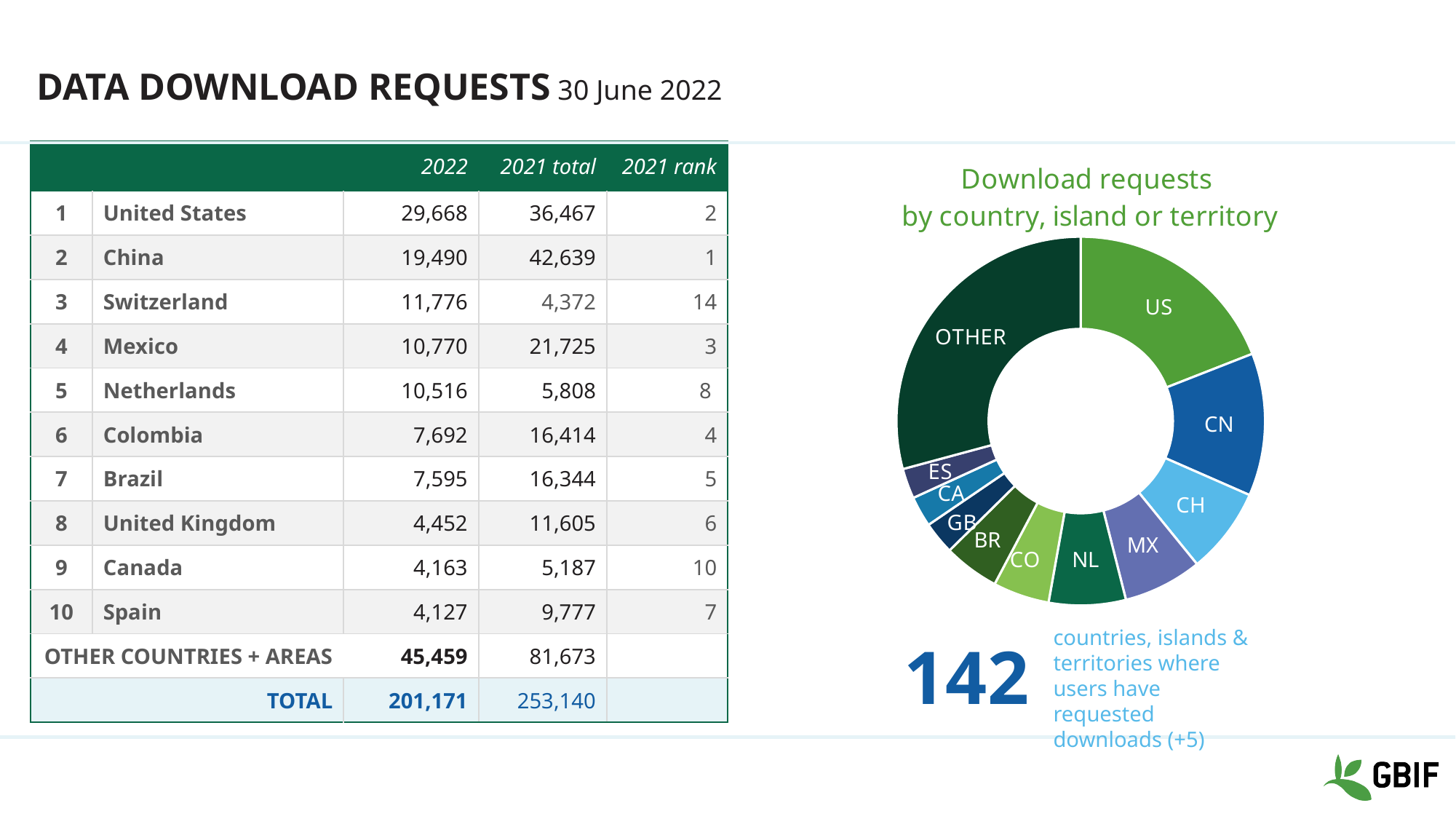
In the donut chart, which slice is larger, NL or CO? NL What is the total number of download requests in 2022 shown in the table? 201,171 In the donut chart, which slice is larger, US or CN? US Excluding the OTHER slice, which country has the largest slice in the donut chart? US In the donut chart, which slice is larger, OTHER or US? OTHER What is the title of the donut chart? Download requests by country, island or territory According to the table on the slide, how many download requests did the OTHER COUNTRIES + AREAS slice represent in 2022? 45,459 According to the table on the slide, how many download requests did the United States (the US slice) have in 2022? 29,668 How many slices does the donut chart have? 11 What kind of chart is shown on the right of the slide? donut chart Which slice of the donut chart is the largest? OTHER